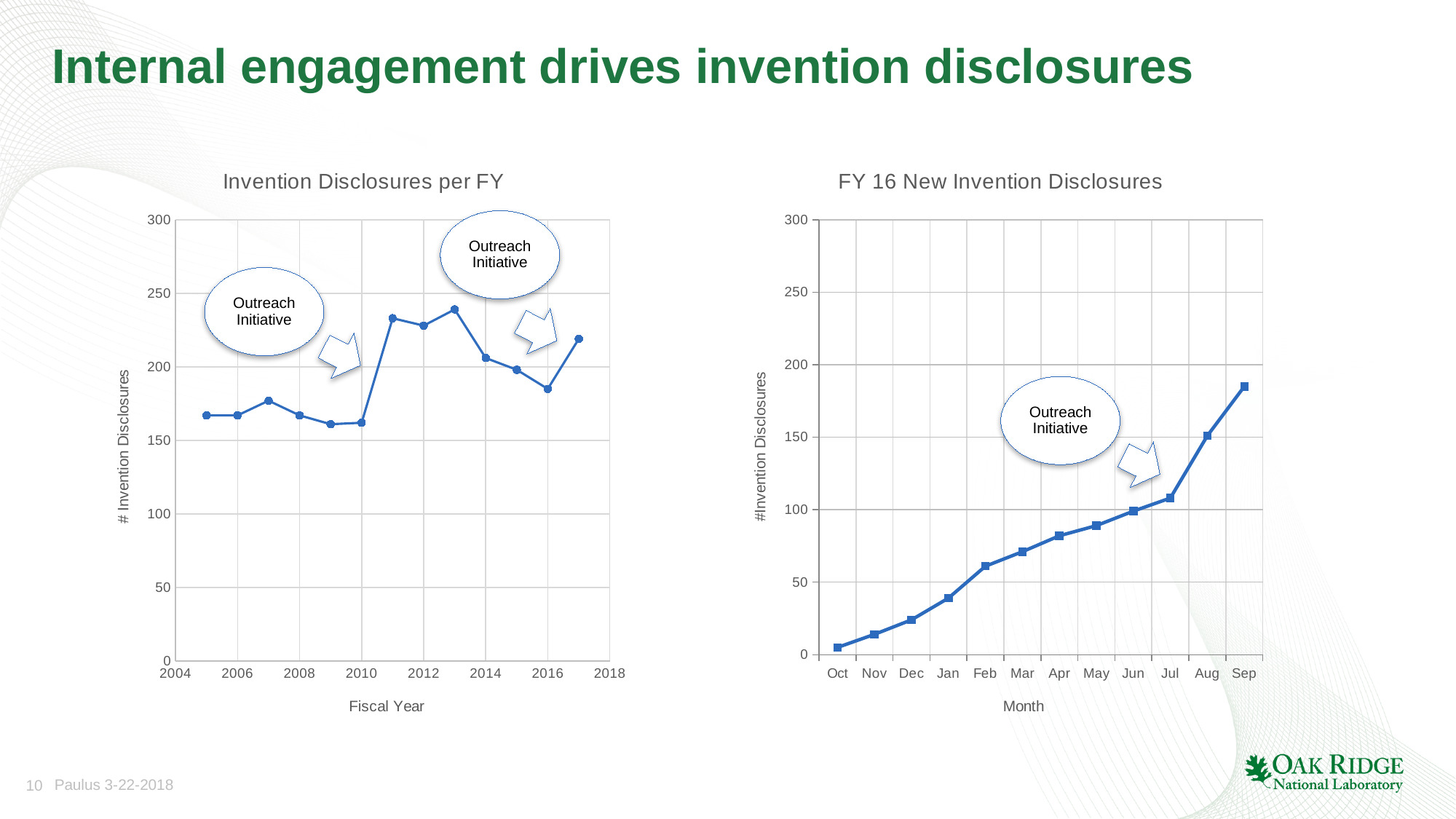
In the 'FY 16 New Invention Disclosures' chart, which month has the highest value? Sep In the 'Invention Disclosures per FY' chart, is the value for 2016 greater or less than 200? less In the 'FY 16 New Invention Disclosures' chart, do the values rise or fall from Oct to Sep? rise In the 'Invention Disclosures per FY' chart, which fiscal year has the highest number of invention disclosures? 2013 In the 'Invention Disclosures per FY' chart, is the value for 2011 greater or less than 200? greater What kind of chart is the 'FY 16 New Invention Disclosures' chart? line chart In the 'Invention Disclosures per FY' chart, which is larger, the value for 2010 or the value for 2011? 2011 What kind of chart is the 'Invention Disclosures per FY' chart? line chart In the 'FY 16 New Invention Disclosures' chart, is the value for Sep greater or less than 150? greater What is the x-axis label of the 'Invention Disclosures per FY' chart? Fiscal Year In the 'FY 16 New Invention Disclosures' chart, how many months are plotted? 12 In the 'FY 16 New Invention Disclosures' chart, which month has the lowest value? Oct